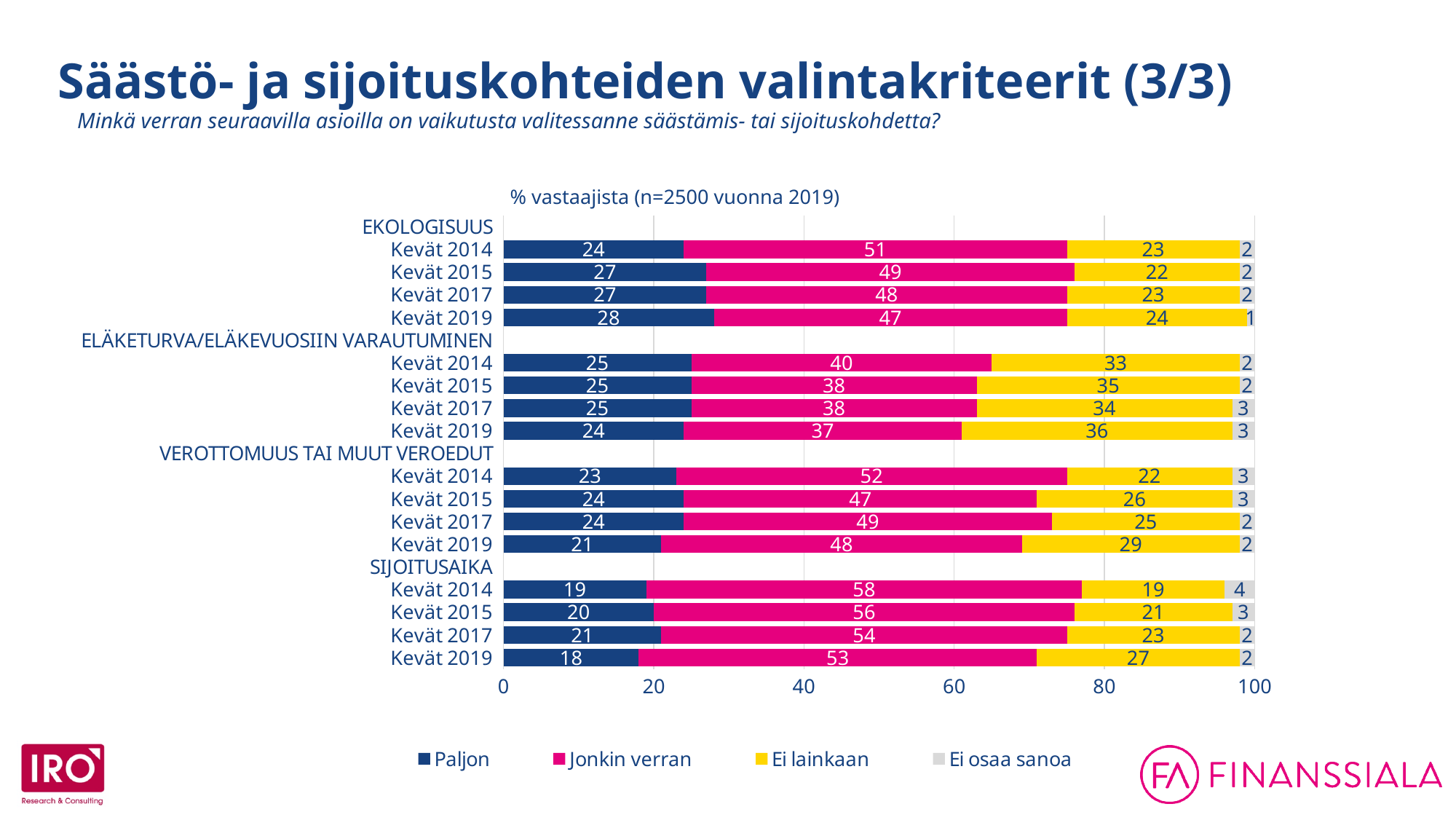
Which is larger: the "Paljon" value for Ekologisuus in Kevät 2019 or for Sijoitusaika in Kevät 2019? Ekologisuus Kevät 2019 What is the total of the Ekologisuus Kevät 2014 bar? 100 What is the value of "Ei lainkaan" for Eläketurva/eläkevuosiin varautuminen in Kevät 2019? 36 How many series does the legend list? 4 Among the Sijoitusaika bars, which year has the highest "Jonkin verran" value? Kevät 2014 Among the Verottomuus tai muut veroedut bars, which year has the lowest "Paljon" value? Kevät 2019 What is the value of "Jonkin verran" for Sijoitusaika in Kevät 2014? 58 What kind of chart is shown on the slide? Stacked bar chart What is the difference between the "Ei lainkaan" values for Sijoitusaika in Kevät 2019 and Kevät 2014? 8 Which legend entry is shown in yellow? Ei lainkaan What is the value of "Paljon" for Ekologisuus in Kevät 2019? 28 What is the value of "Ei osaa sanoa" for Sijoitusaika in Kevät 2014? 4